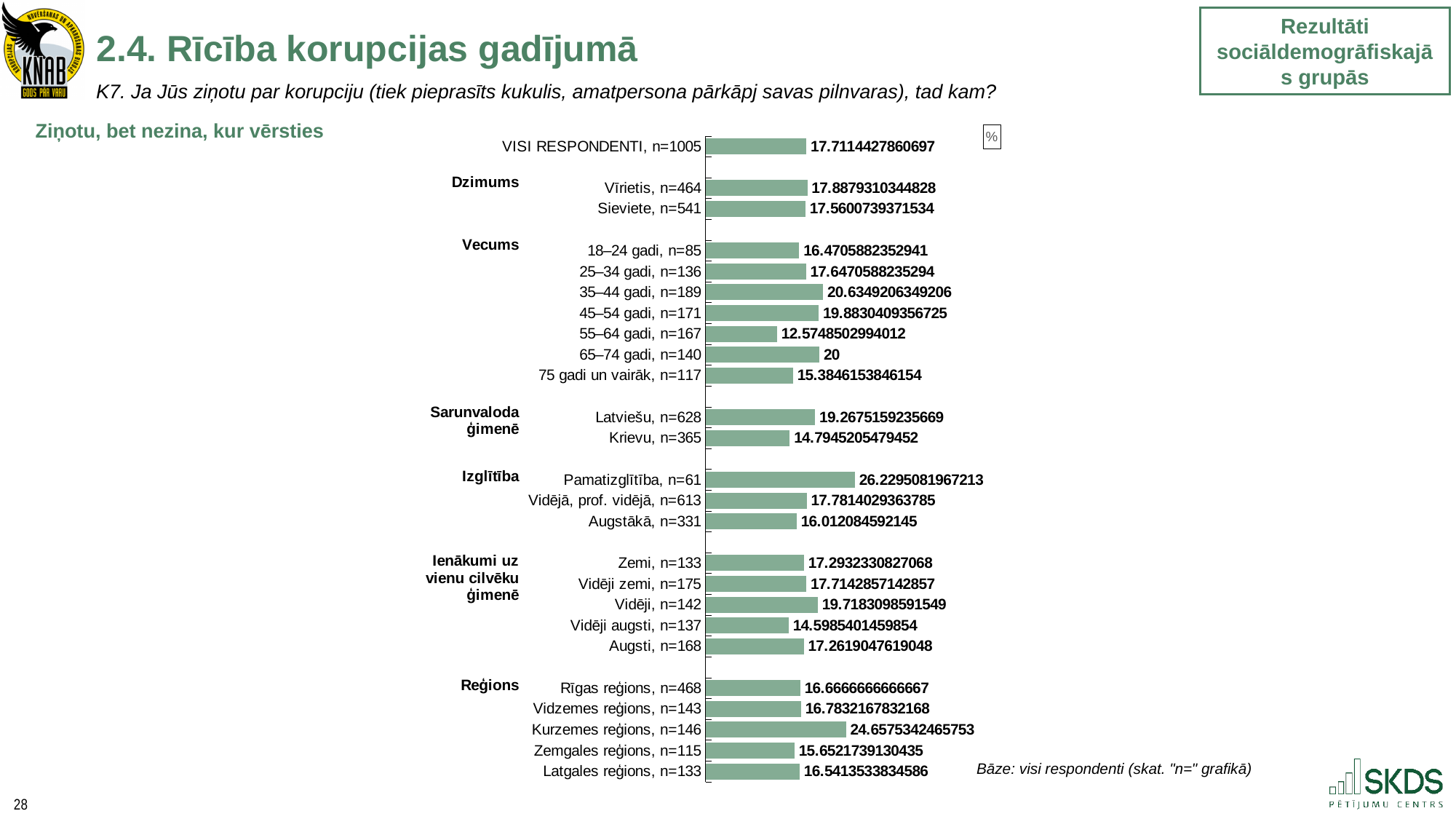
What is the value for Kurzemes reģions, n=146? 24.6575342465753 What is the value for Pamatizglītība, n=61? 26.2295081967213 What is the difference between the values for Latviešu, n=628 and Krievu, n=365? 4.4729953756217 How many bars (categories) are plotted in the chart? 25 Which has the larger value: 35–44 gadi, n=189 or 75 gadi un vairāk, n=117? 35–44 gadi, n=189 Which category has the highest value in the chart? Pamatizglītība, n=61 What is the value for 65–74 gadi, n=140? 20 Which category has the lowest value in the chart? 55–64 gadi, n=167 What is the value for VISI RESPONDENTI, n=1005? 17.7114427860697 What kind of chart is shown on the slide? Bar chart Which has the larger value: Kurzemes reģions, n=146 or Rīgas reģions, n=468? Kurzemes reģions, n=146